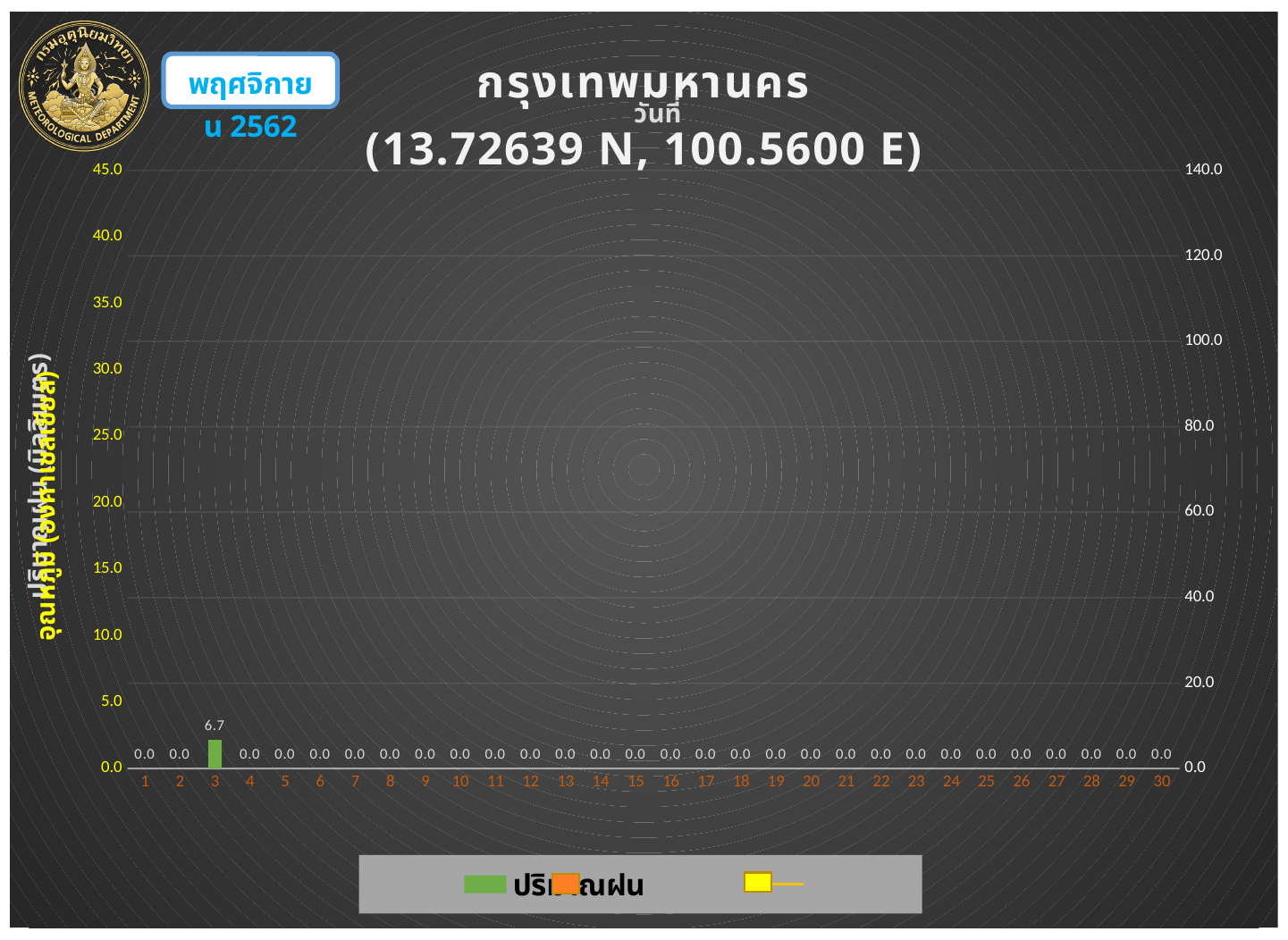
Is the bar value for day 3 greater or less than 10.0? less What is the difference between the bar values for day 3 and day 4? 6.7 What is the value of the bar for day 15? 0.0 What is the maximum value shown on the right vertical axis? 140.0 What is the value of the bar for day 30? 0.0 How many days are shown on the x axis? 30 What is the value of the bar for day 3? 6.7 Which day has the highest bar value? 3 What is the maximum value shown on the left vertical axis? 45.0 What kind of chart is this? bar chart Which is larger, the bar value for day 3 or for day 10? day 3 What is the total of the bar values for days 1 through 5? 6.7